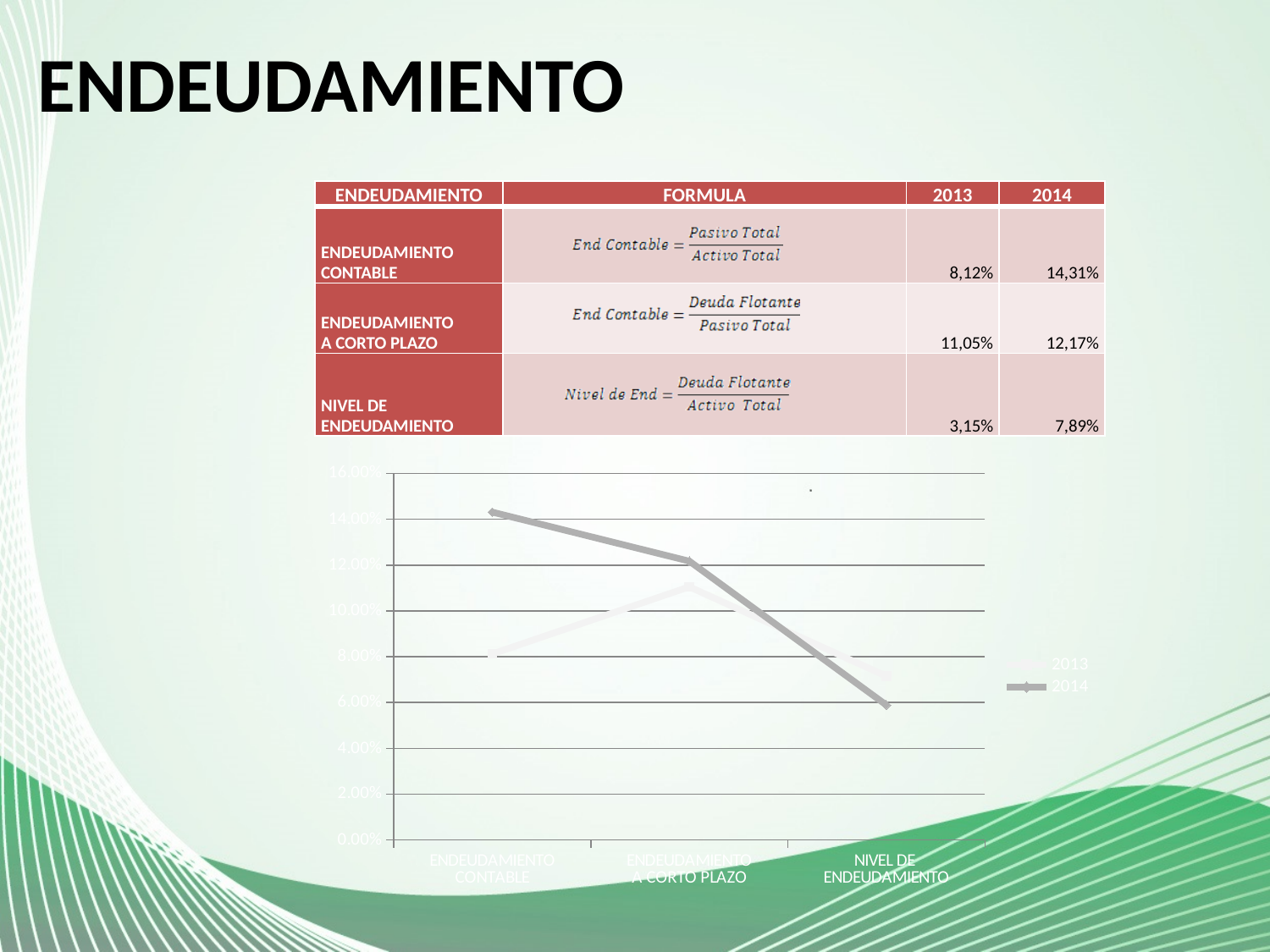
How many categories are plotted along the x axis of the chart? 3 For 2013, which is larger: ENDEUDAMIENTO CONTABLE or ENDEUDAMIENTO A CORTO PLAZO? ENDEUDAMIENTO A CORTO PLAZO What kind of chart is shown on the slide? line chart Which years are listed in the chart legend? 2013 and 2014 Does the 2014 line rise or fall from ENDEUDAMIENTO CONTABLE to NIVEL DE ENDEUDAMIENTO? fall Which category has the lowest 2013 value in the chart? NIVEL DE ENDEUDAMIENTO How many series does the chart legend list? 2 Is the 2014 value for ENDEUDAMIENTO CONTABLE greater or less than 12.00%? greater Which category has the highest 2014 value in the chart? ENDEUDAMIENTO CONTABLE According to the table on the slide, what is the 2014 value for ENDEUDAMIENTO CONTABLE? 14,31%